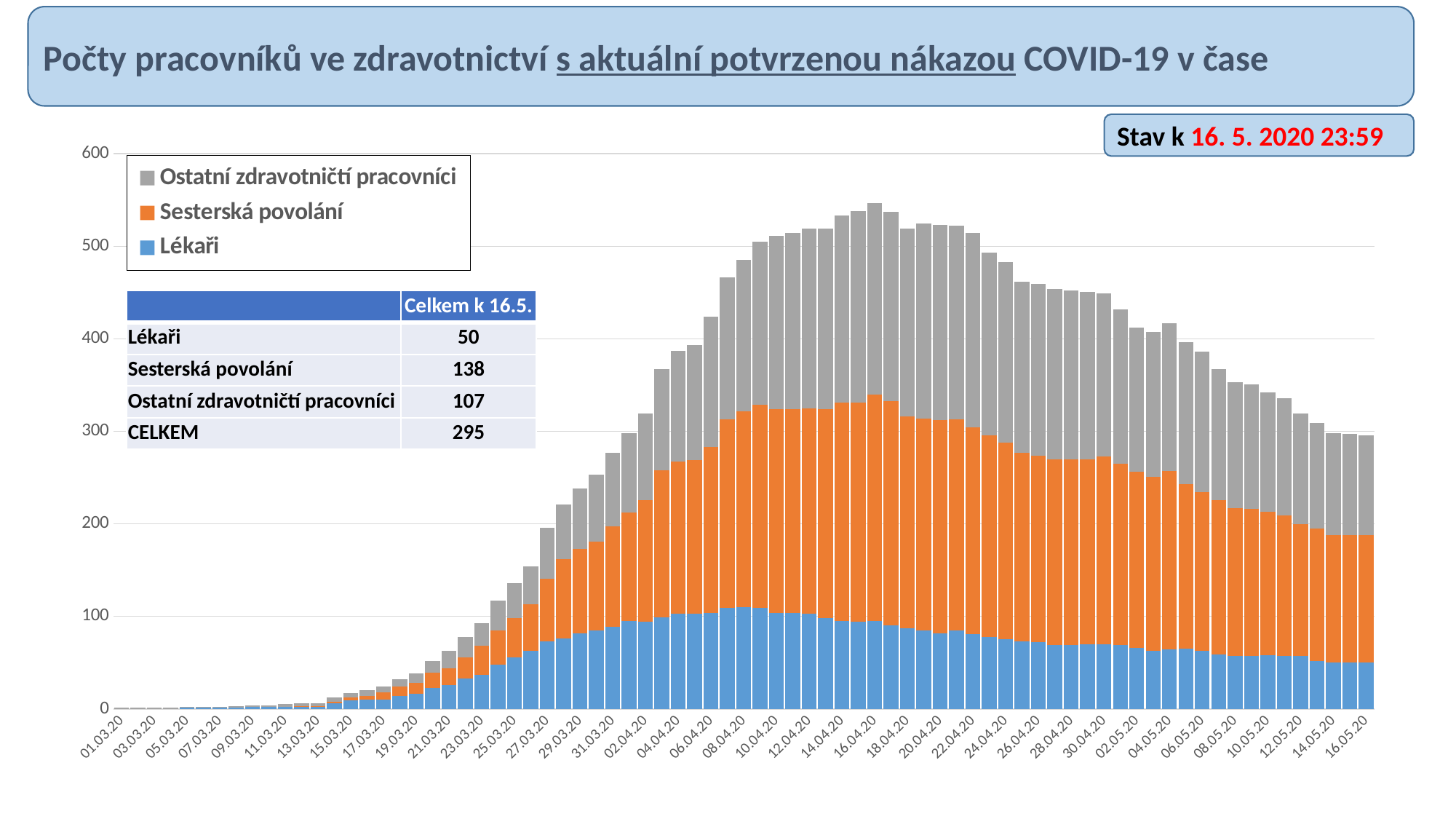
Do the total values rise or fall along the x axis from 16.04.20 to 16.05.20? fall What kind of chart is shown on the slide? bar chart As of 16.5., what is the difference between the values for Sesterská povolání and Lékaři? 88 According to the table on the slide, what is the value for Sesterská povolání as of 16.5.? 138 As of 16.5., which is larger: Sesterská povolání or Ostatní zdravotničtí pracovníci? Sesterská povolání How many series does the chart legend list? 3 According to the table on the slide, what is the value for Ostatní zdravotničtí pracovníci as of 16.5.? 107 Which series has the highest value as of 16.5.? Sesterská povolání What is the total (CELKEM) of the stacked bar for 16.05.20? 295 According to the table on the slide, what is the value for Lékaři as of 16.5.? 50 Is the total height of the stacked bar for 16.04.20 greater or less than 500? greater What colour represents Lékaři in the chart legend? blue